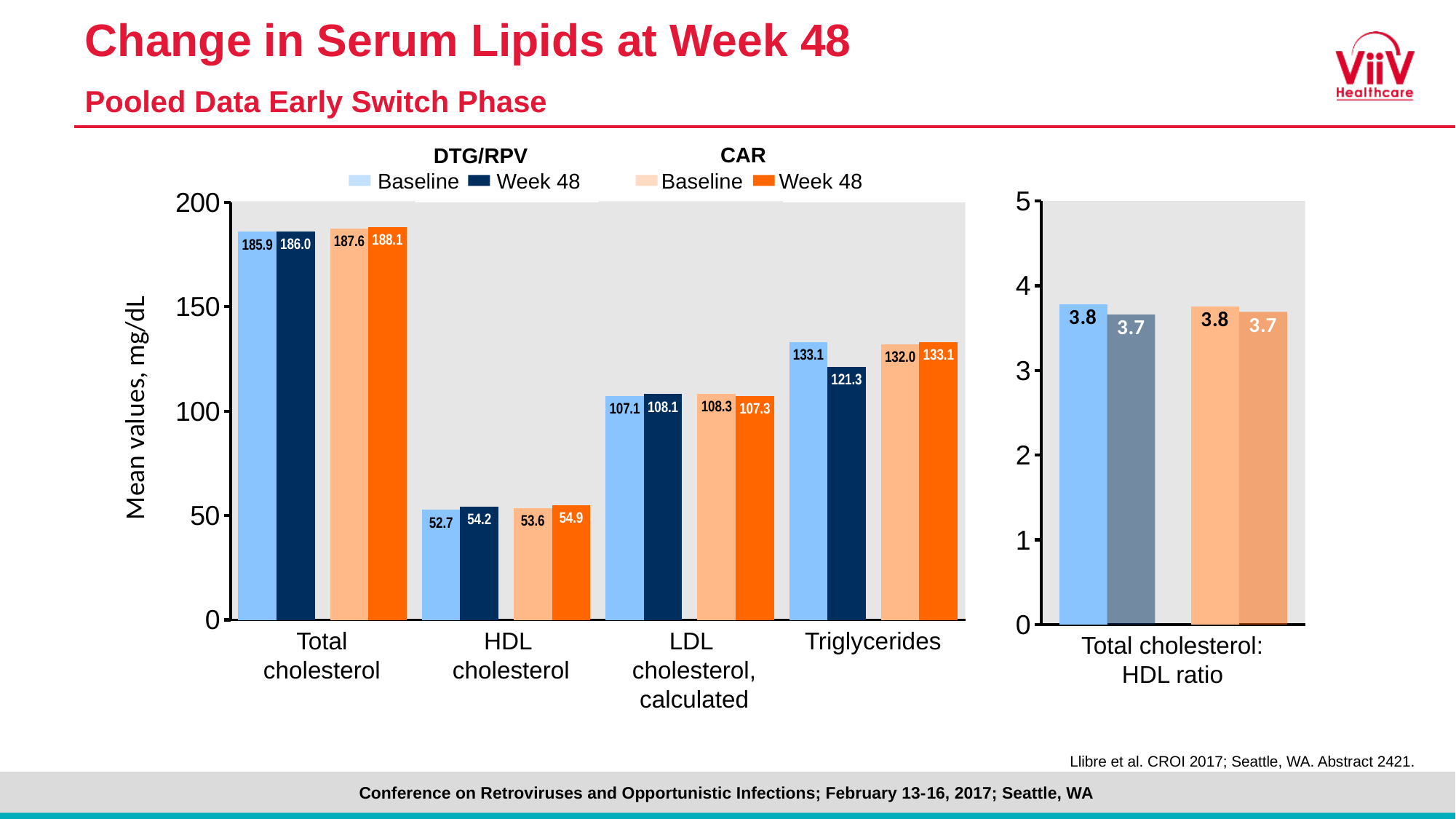
In the left chart, which is larger for Triglycerides: the DTG/RPV Week 48 value or the CAR Week 48 value? CAR Week 48 In the left chart, what is the CAR Week 48 value for Triglycerides? 133.1 How many categories are shown on the x axis of the left chart? 4 In the left chart, which category has the lowest values? HDL cholesterol How many series does the legend of the left chart list? 4 In the left chart, which category has the highest values? Total cholesterol In the left chart, what is the CAR Baseline value for LDL cholesterol, calculated? 108.3 What type of chart is the left chart? Bar chart In the right chart (Total cholesterol: HDL ratio), what is the DTG/RPV Week 48 value? 3.7 In the left chart, what is the DTG/RPV Week 48 value for HDL cholesterol? 54.2 In the left chart, what is the difference between the DTG/RPV Baseline and DTG/RPV Week 48 values for Triglycerides? 11.8 In the left chart, what is the DTG/RPV Baseline value for Total cholesterol? 185.9